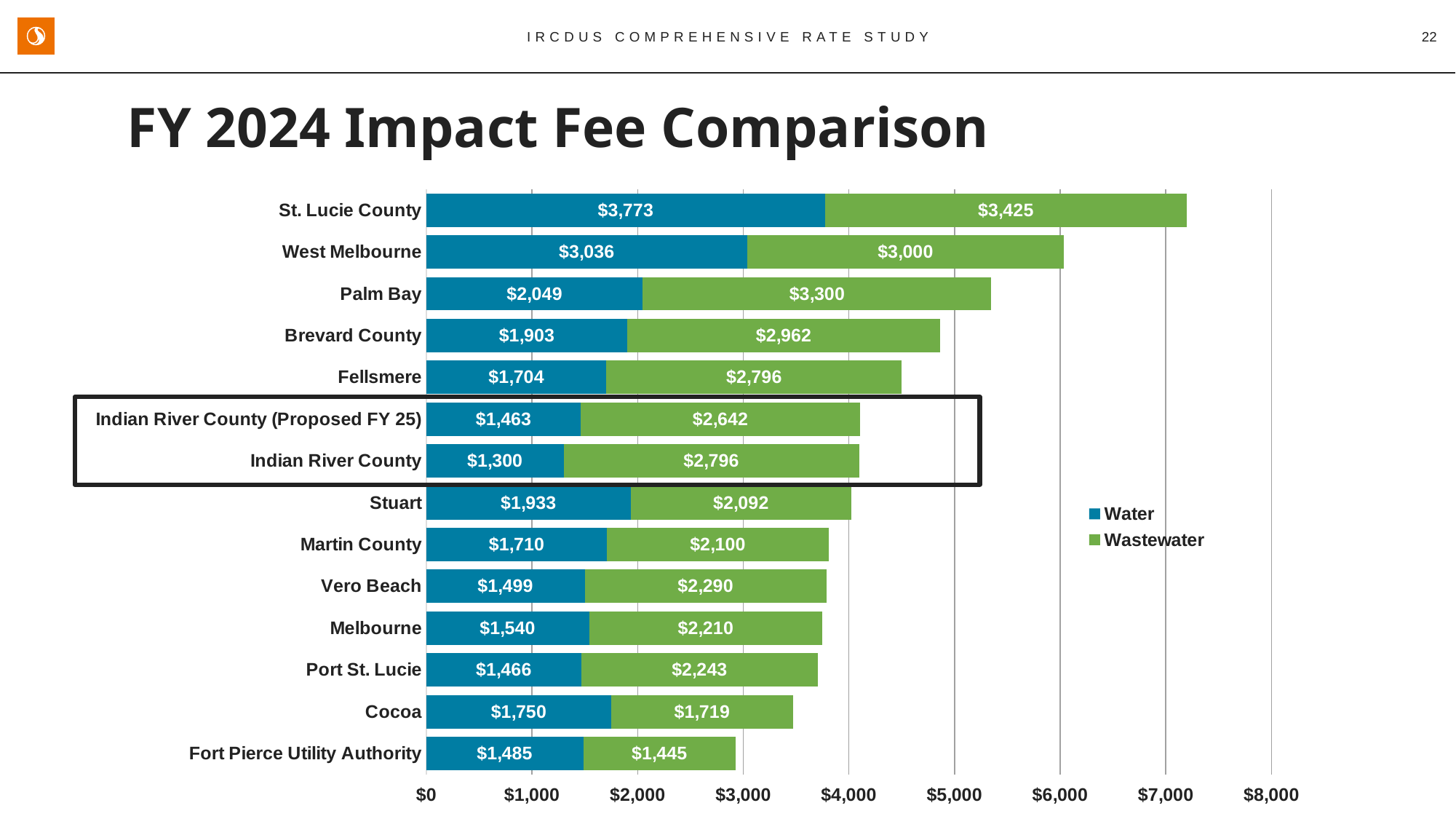
Which is larger for Cocoa, the Water fee or the Wastewater fee? Water Which utility has the highest Water impact fee? St. Lucie County Which utility has the lowest Water impact fee? Indian River County What is the total impact fee (Water plus Wastewater) for Indian River County? $4,096 How much higher is the Water fee for Indian River County (Proposed FY 25) than for Indian River County? $163 How many series does the legend list? 2 What is the Wastewater impact fee for Indian River County (Proposed FY 25)? $2,642 Which utility has the lowest Wastewater impact fee? Fort Pierce Utility Authority What is the Water impact fee for Palm Bay? $2,049 What is the total impact fee (Water plus Wastewater) for St. Lucie County? $7,198 What type of chart is shown on the slide? Stacked bar chart How many utilities are listed on the chart? 14